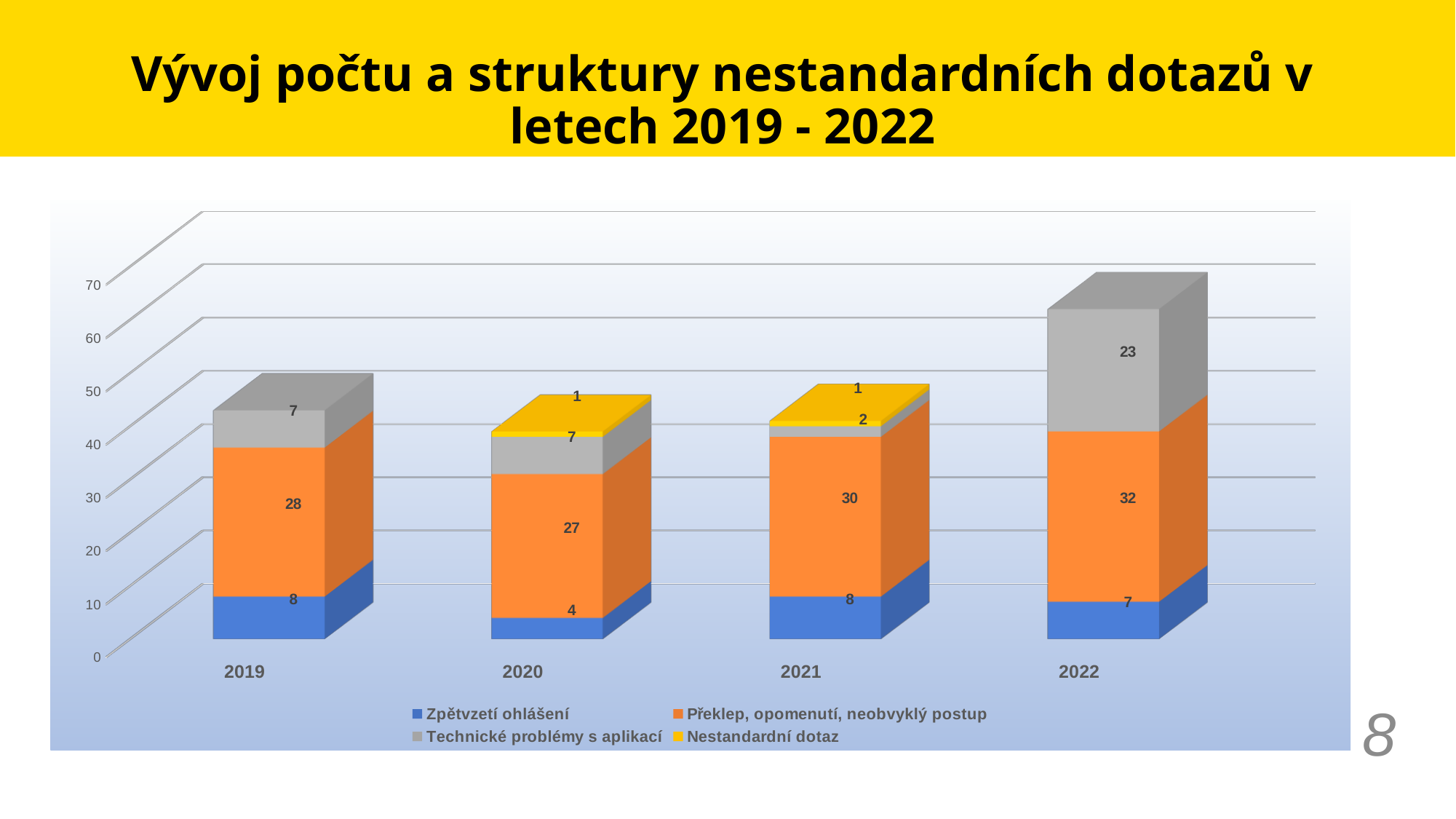
How many series does the legend list? 4 What is the value for Technické problémy s aplikací in 2022? 23 What is the total of the stacked bar for 2022? 62 In which year is the value for Zpětvzetí ohlášení the lowest? 2020 What is the value for Nestandardní dotaz in 2021? 1 What kind of chart is shown on the slide? Stacked bar chart How many years are shown on the x axis? 4 What is the value for Zpětvzetí ohlášení in 2020? 4 In which year is the value for Technické problémy s aplikací the highest? 2022 Which year has the larger value for Překlep, opomenutí, neobvyklý postup, 2020 or 2021? 2021 What is the value for Překlep, opomenutí, neobvyklý postup in 2021? 30 What is the difference between the Překlep, opomenutí, neobvyklý postup values for 2022 and 2019? 4